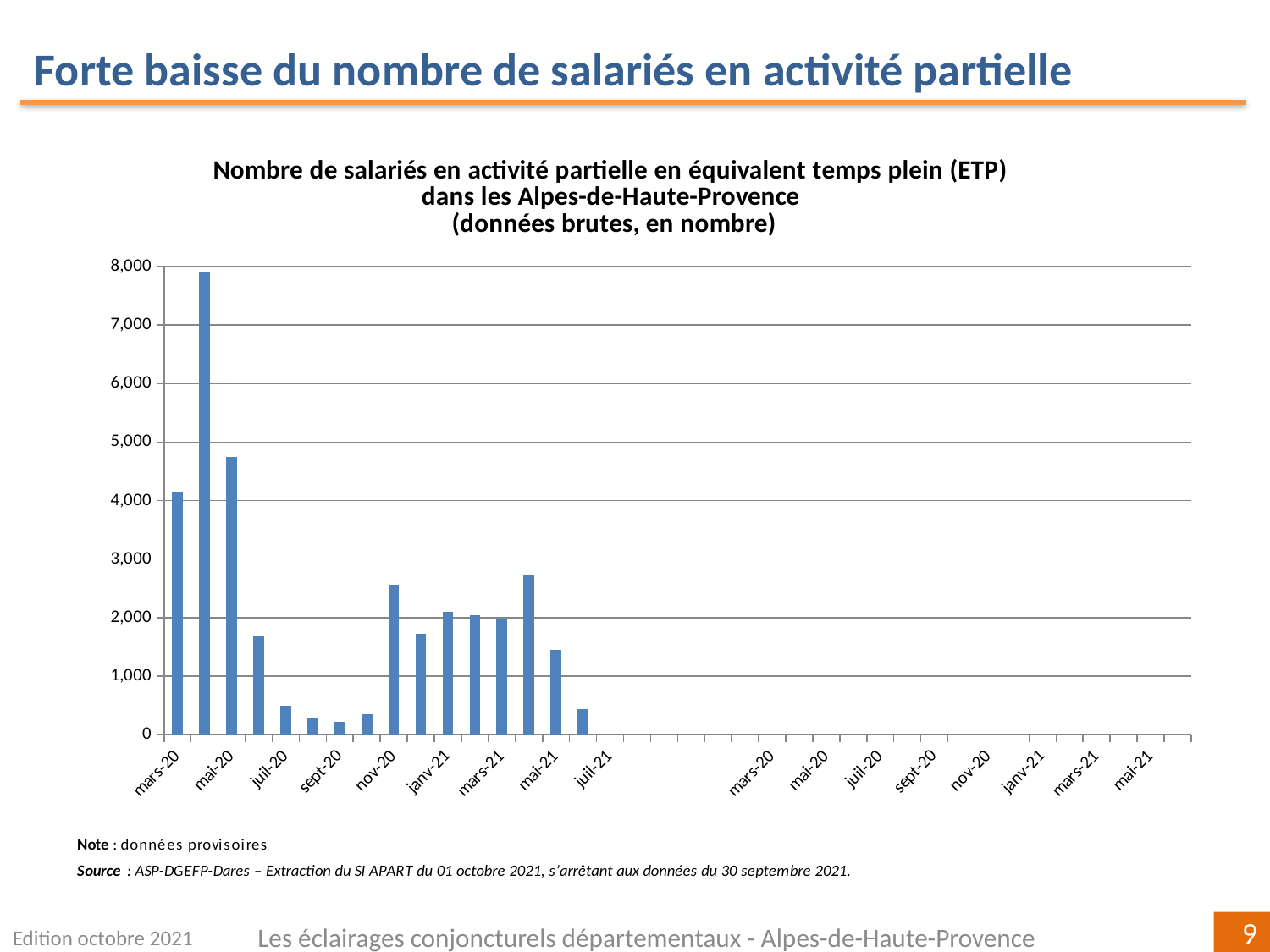
Is the value for mai-21 greater or less than 1,000? greater Is the value for mars-20 greater or less than 3,000? greater What is the title of the chart? Nombre de salariés en activité partielle en équivalent temps plein (ETP) dans les Alpes-de-Haute-Provence (données brutes, en nombre) Is the value for sept-20 greater or less than 1,000? less Which is larger, the value for mars-20 or the value for juil-20? mars-20 What kind of chart is shown on the slide? bar chart Do the values rise or fall from mai-20 to sept-20? fall Which is larger, the value for nov-20 or the value for mai-21? nov-20 What is the highest value shown on the vertical axis? 8,000